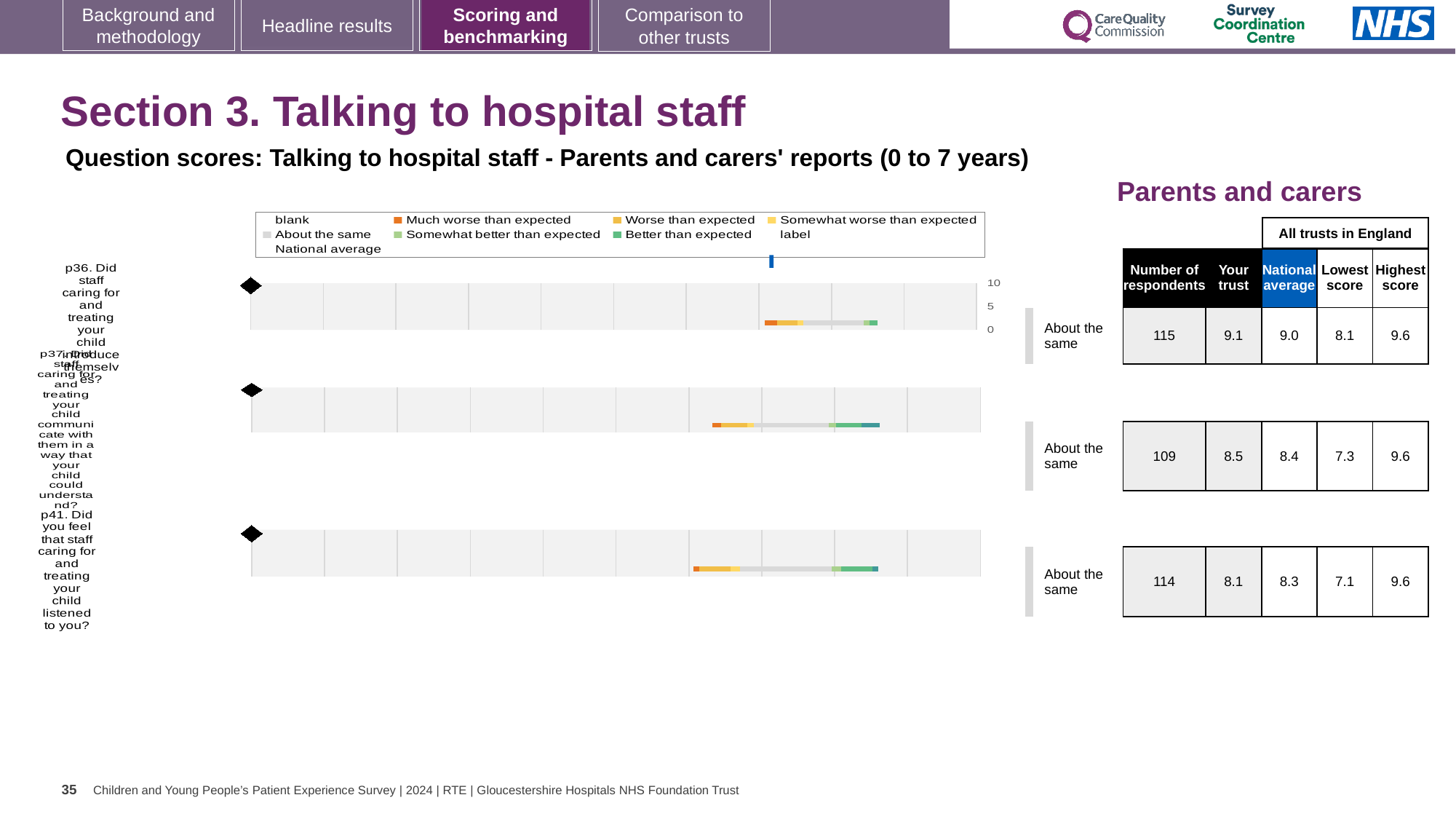
What benchmark category label is shown next to each of the three charts? About the same For p36, what is the difference between the 'Your trust' score and the national average? 0.1 How many survey questions are plotted on the slide's charts? 3 What is the national average score for p37 (Did staff communicate with your child in a way they could understand)? 8.4 For p41, which is larger: the 'Your trust' score or the national average? National average Which question has the lowest 'Your trust' score? p41 What is the 'Your trust' score for p36 (Did staff caring for and treating your child introduce themselves)? 9.1 What is the highest score among all trusts in England for p37? 9.6 How many respondents answered p41 (Did you feel that staff listened to you)? 114 Which question has the highest 'Your trust' score? p36 For p41, what is the difference between the highest score and the lowest score across all trusts in England? 2.5 What kind of chart is used to show the question scores on this slide? Bar chart